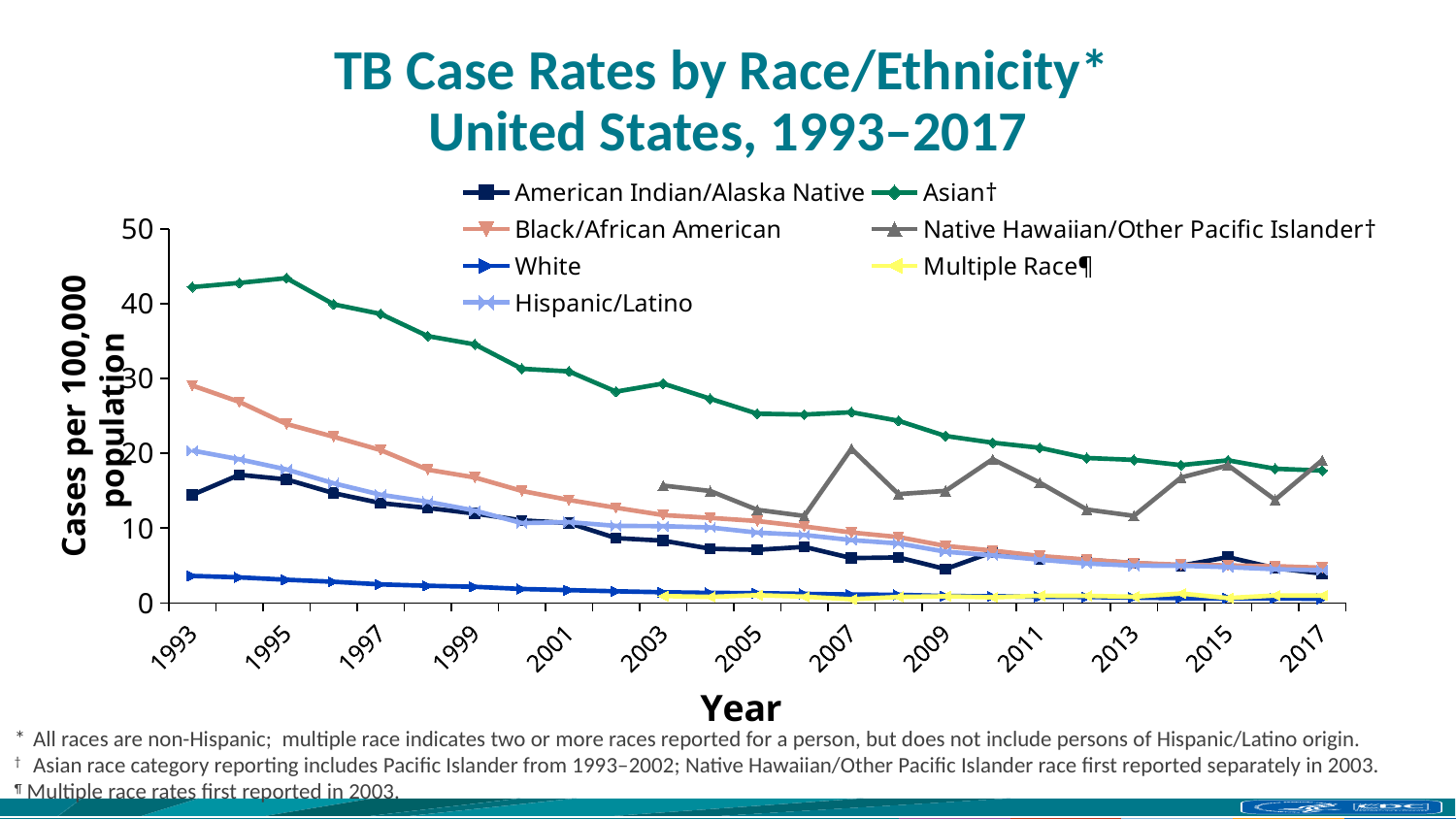
In 1993, which is larger: the TB case rate for Asian or for Black/African American? Asian Is the TB case rate for Black/African American in 1993 greater or less than 20? greater How many series does the legend list? 7 What is the label of the y axis? Cases per 100,000 population Which race/ethnicity has the highest TB case rate in 1993? Asian Which race/ethnicity has the lowest TB case rate in 1993? White Does the TB case rate for Asian generally rise or fall from 1993 to 2017? fall Is the TB case rate for Asian in 2017 greater or less than 20? less Is the TB case rate for White in 1993 greater or less than 10? less What kind of chart is shown on the slide? line chart In 1993, which is larger: the TB case rate for Black/African American or for Hispanic/Latino? Black/African American